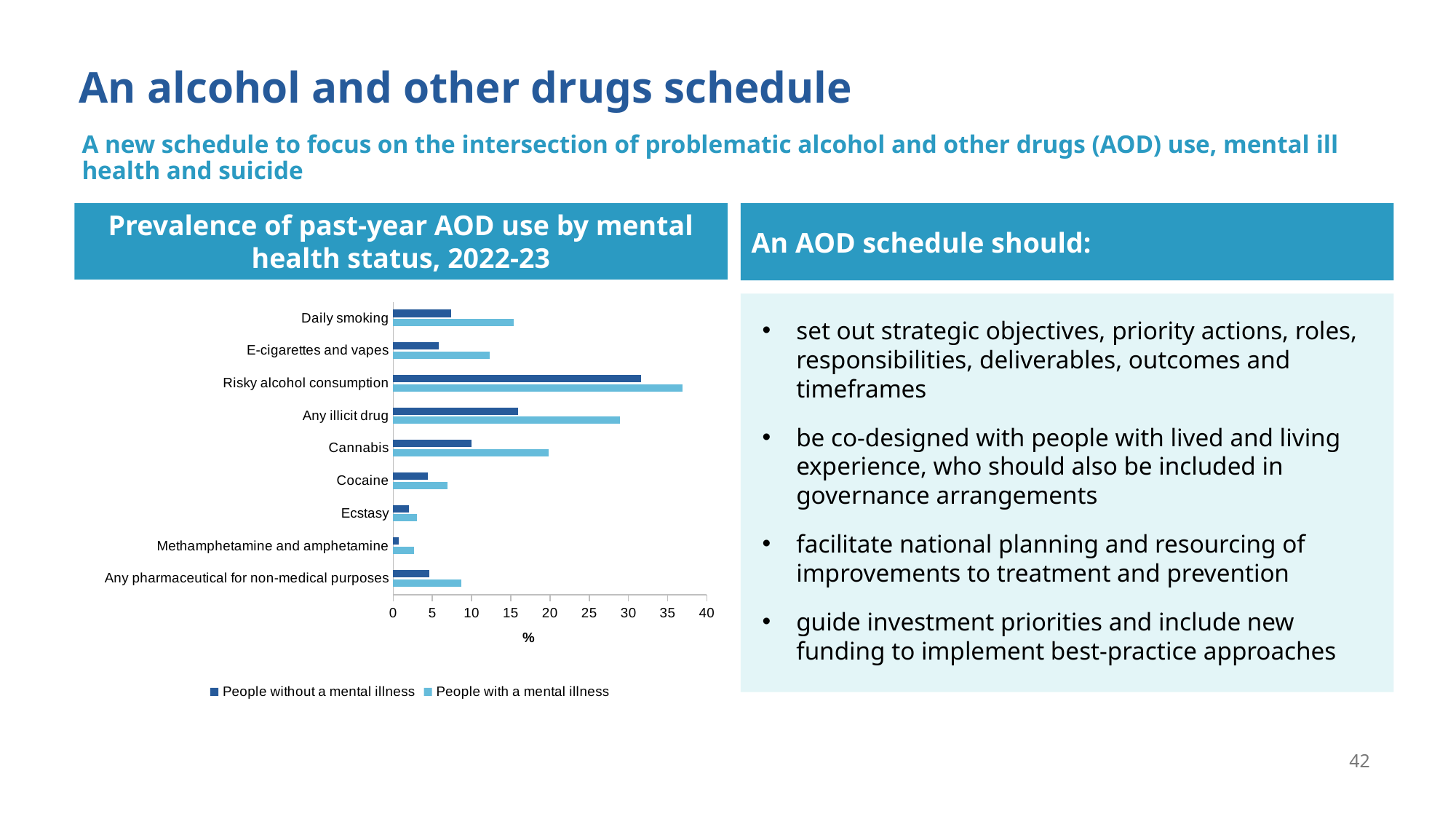
Which category has the highest value for people with a mental illness? Risky alcohol consumption What unit is shown on the horizontal axis of the chart? % How many series does the chart legend list? 2 What kind of chart is shown under 'Prevalence of past-year AOD use by mental health status, 2022-23'? Bar chart Among people with a mental illness, which is larger: the value for Cannabis or the value for Daily smoking? Cannabis Is the value for Any illicit drug among people with a mental illness greater or less than 25? greater Is the value for Cocaine among people with a mental illness greater or less than 10? less For Any illicit drug, which group has the larger value: people with a mental illness or people without a mental illness? People with a mental illness Is the value for Cannabis among people without a mental illness greater or less than 15? less How many categories are plotted in the chart? 9 Which category has the lowest value for people without a mental illness? Methamphetamine and amphetamine